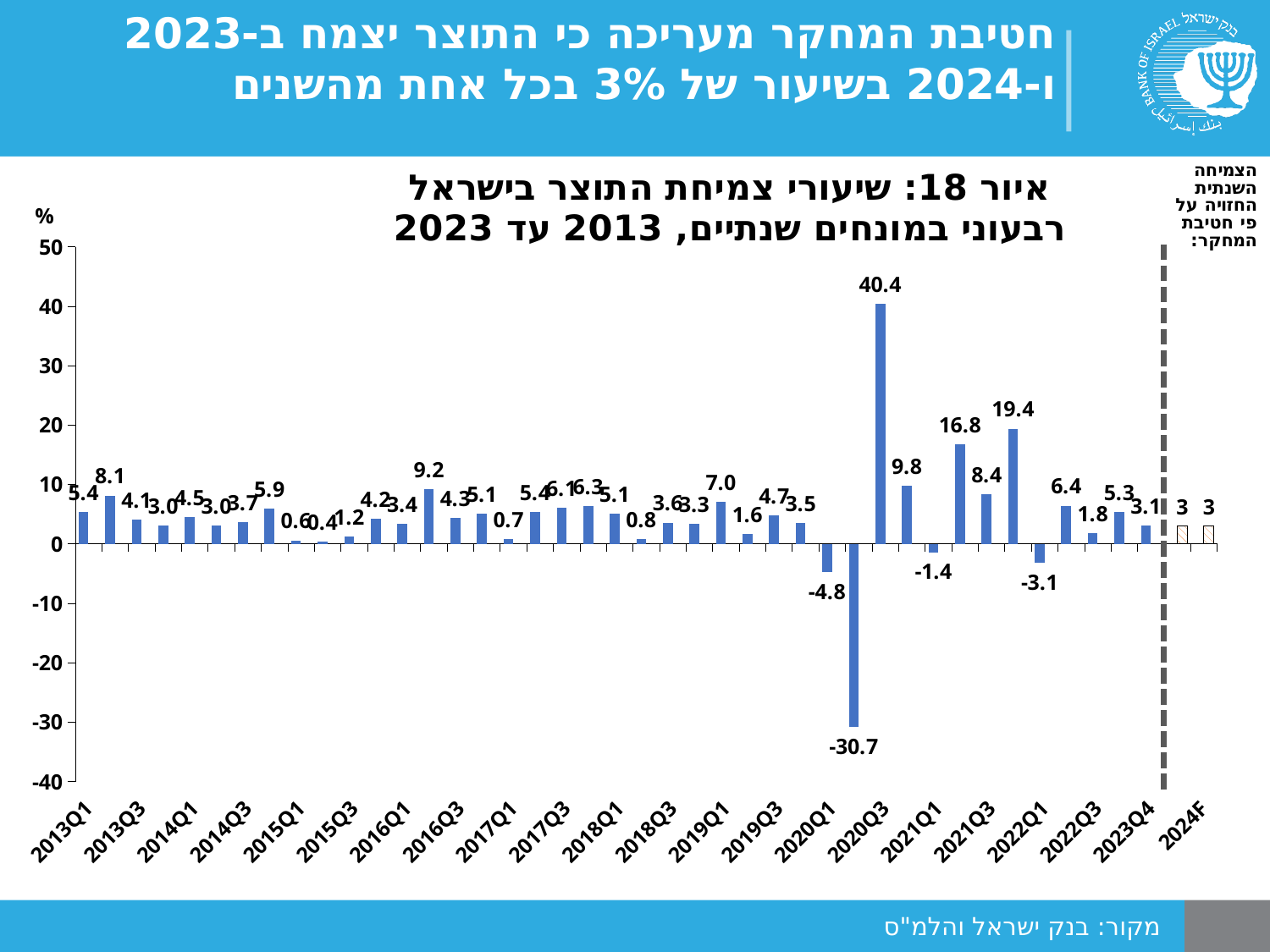
What is the lowest value shown in the chart? -30.7 What is the growth rate shown for 2020Q3? 40.4 What value is shown for the 2024F bar? 3 What unit is indicated at the top of the vertical axis? % Which has a higher growth rate, 2019Q1 or 2019Q3? 2019Q1 What is the growth rate shown for 2022Q1? -3.1 What is the growth rate shown for 2017Q3? 6.1 What is the difference between the values for 2020Q3 and 2021Q3? 32.0 How many bars in the chart show a negative value? 4 What is the growth rate shown for 2020Q1? -4.8 Which quarter has the highest growth rate in the chart? 2020Q3 What type of chart is shown on the slide? Bar chart